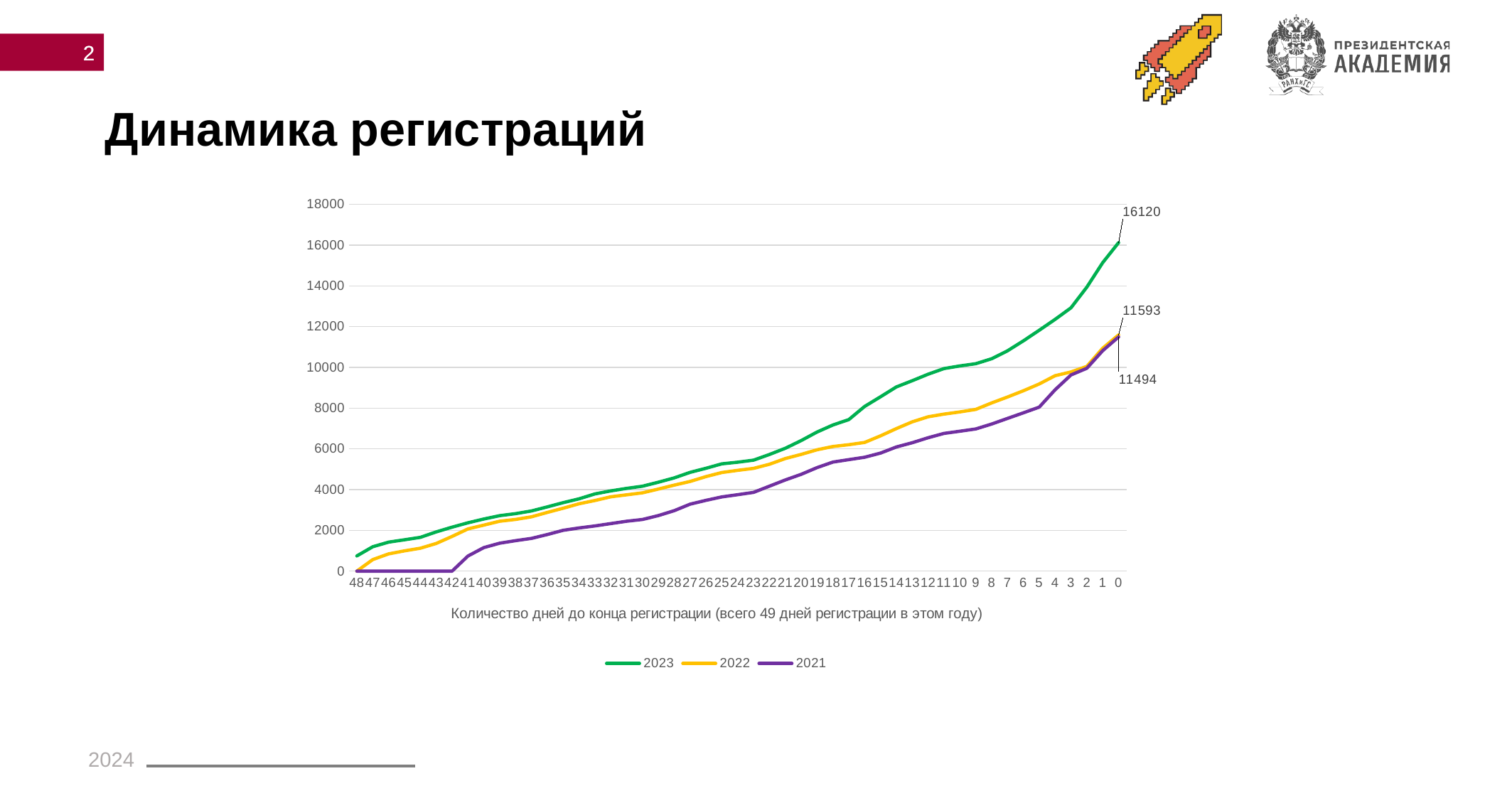
What is the final value of the 2023 series at day 0? 16120 How many series does the legend list? 3 Is the value for the 2023 series at day 16 greater or less than 6000? greater At day 0, which is larger: the 2023 value or the 2021 value? 2023 Which year's series has the lowest value at day 0? 2021 What is the final value of the 2022 series at day 0? 11593 What kind of chart is shown on the slide? line chart Which year's series reaches the highest value at day 0? 2023 What is the difference between the 2023 and 2022 values at day 0? 4527 Do the values of the 2023 series rise or fall from left to right along the x axis? rise What is the final value of the 2021 series at day 0? 11494 What is the difference between the 2022 and 2021 values at day 0? 99